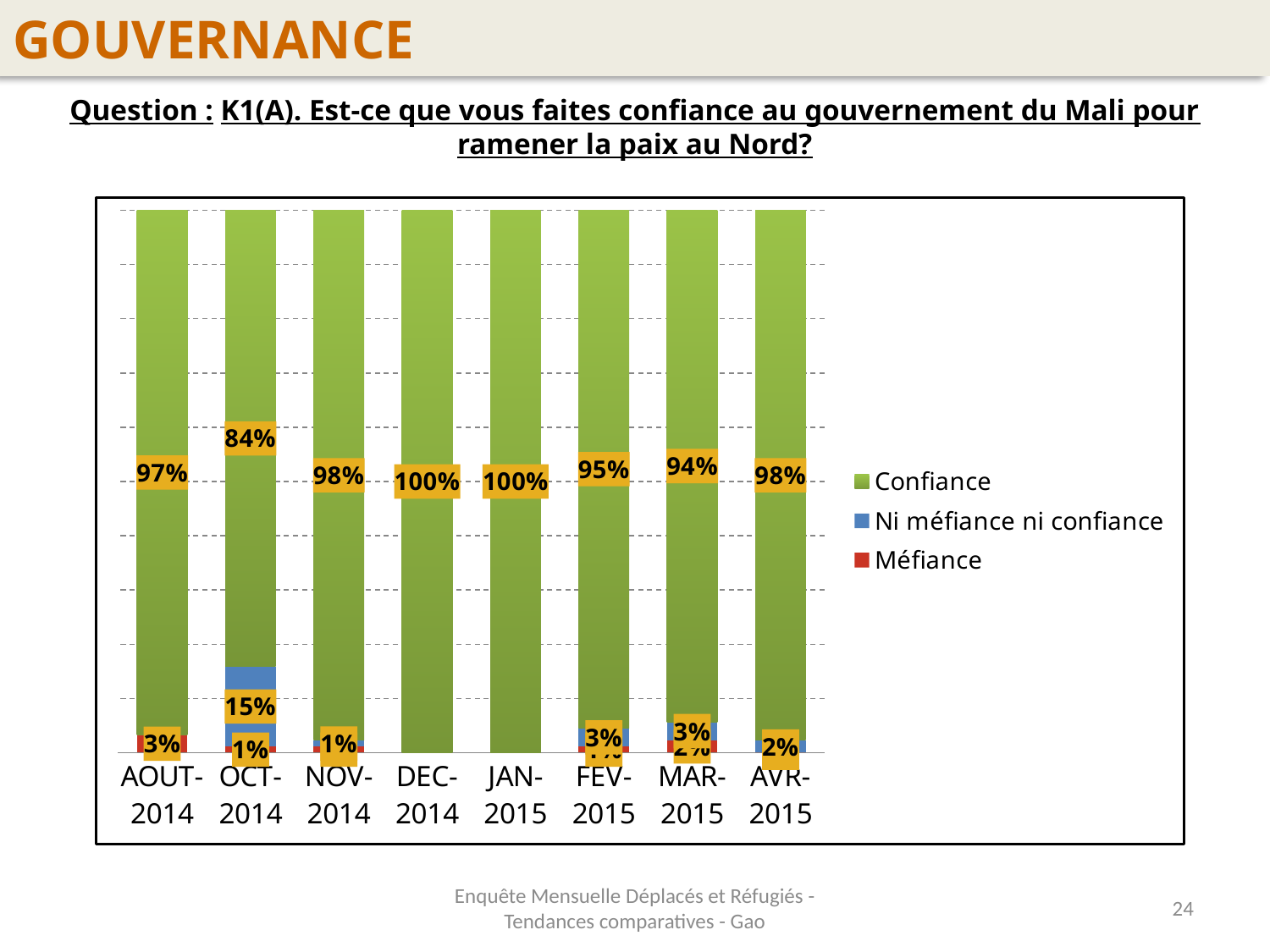
Which month has the lowest Confiance value? OCT-2014 Which months show a Confiance value of 100%? DEC-2014 and JAN-2015 Is the Confiance value higher in FEV-2015 or MAR-2015? FEV-2015 What is the Confiance value for AOUT-2014? 97% Which series is shown in green in the legend? Confiance What is the Ni méfiance ni confiance value for OCT-2014? 15% What is the Confiance value for OCT-2014? 84% How many series does the legend list? 3 What is the Confiance value for MAR-2015? 94% What kind of chart is shown on the slide? Stacked bar chart How many months are shown on the x axis? 8 What is the difference between the Confiance values for NOV-2014 and OCT-2014? 14%